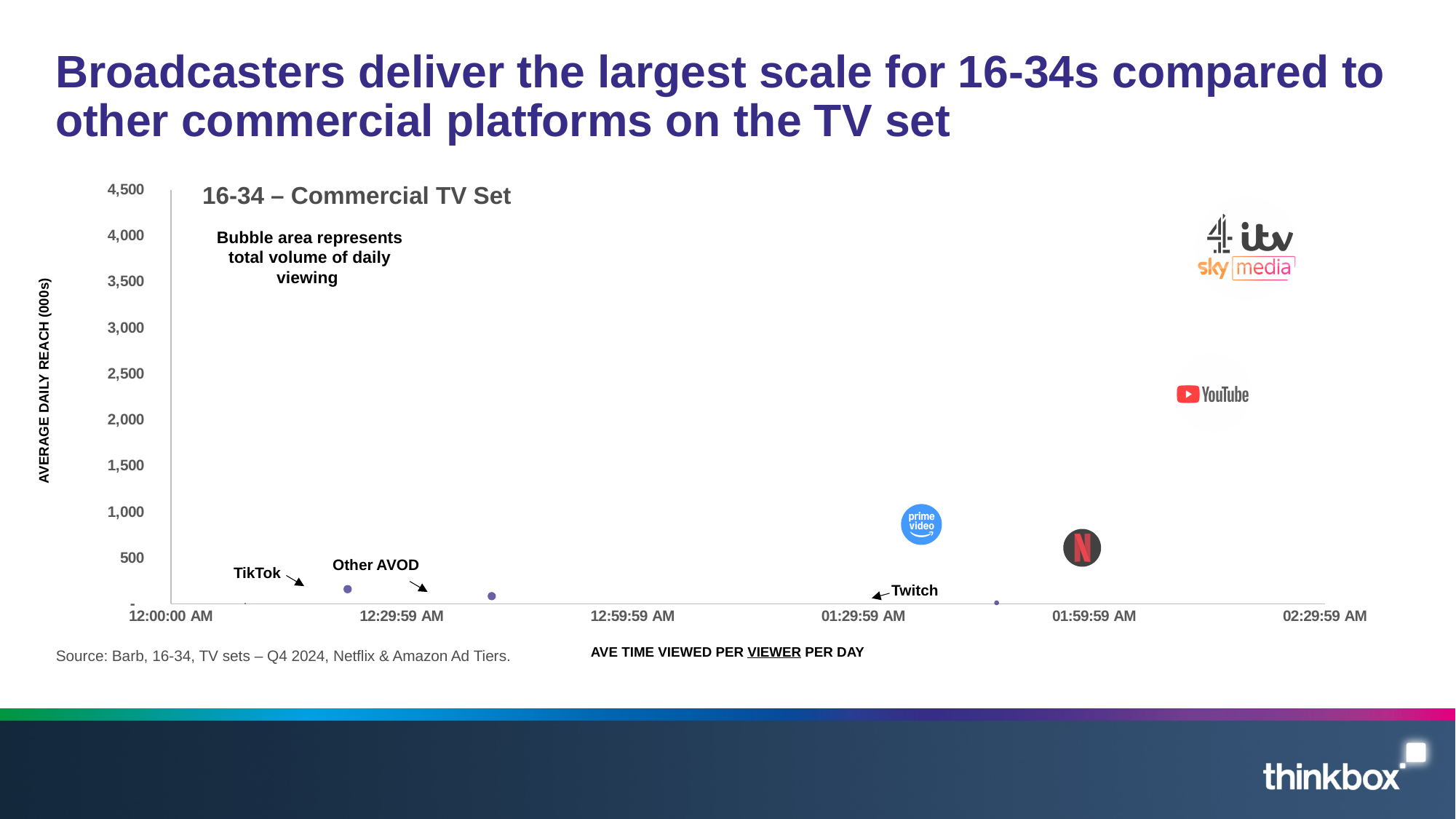
What does the bubble area represent in the chart? Total volume of daily viewing Which platform has the highest average daily reach in the chart? Broadcasters (Channel 4, ITV, Sky Media) Which has the higher average time viewed per viewer per day, Netflix or Prime Video? Netflix Which platform has the lowest average daily reach in the chart? Twitch Which has the higher average daily reach, YouTube or Netflix? YouTube Is the average daily reach for TikTok greater or less than 500? less Is the average daily reach for the broadcasters bubble greater or less than 3,000? greater How many platforms are plotted in the chart? 7 Is the average daily reach for YouTube greater or less than 2,000? greater What kind of chart is shown on the slide? Bubble chart What is the title of the chart? 16-34 – Commercial TV Set